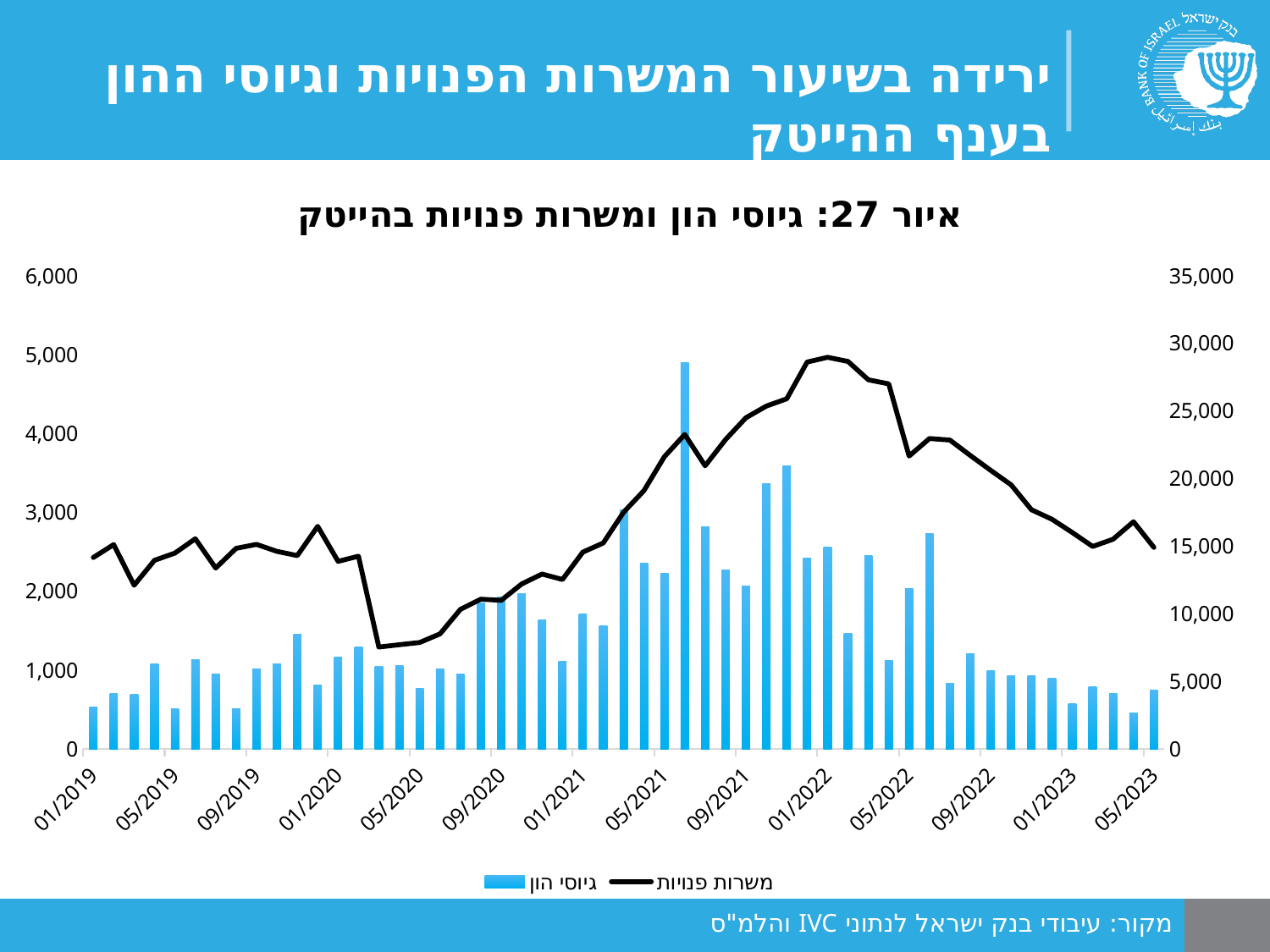
How many series does the legend list? 2 Is the value of the גיוסי הון bar at 01/2019 greater or less than 1,000? less Is the value of the גיוסי הון bar at 01/2022 greater or less than 2,000? greater Which series is drawn as a black line? משרות פנויות Does the משרות פנויות line rise or fall between 05/2022 and 05/2023? fall Is the tallest bar for גיוסי הון greater or less than 4,000? greater What is the title of the chart? איור 27: גיוסי הון ומשרות פנויות בהייטק Which is larger: the גיוסי הון bar at 01/2019 or the גיוסי הון bar at 01/2022? 01/2022 What kind of chart is shown on the slide? A combined bar and line chart In which year does the tallest bar (גיוסי הון) occur? 2021